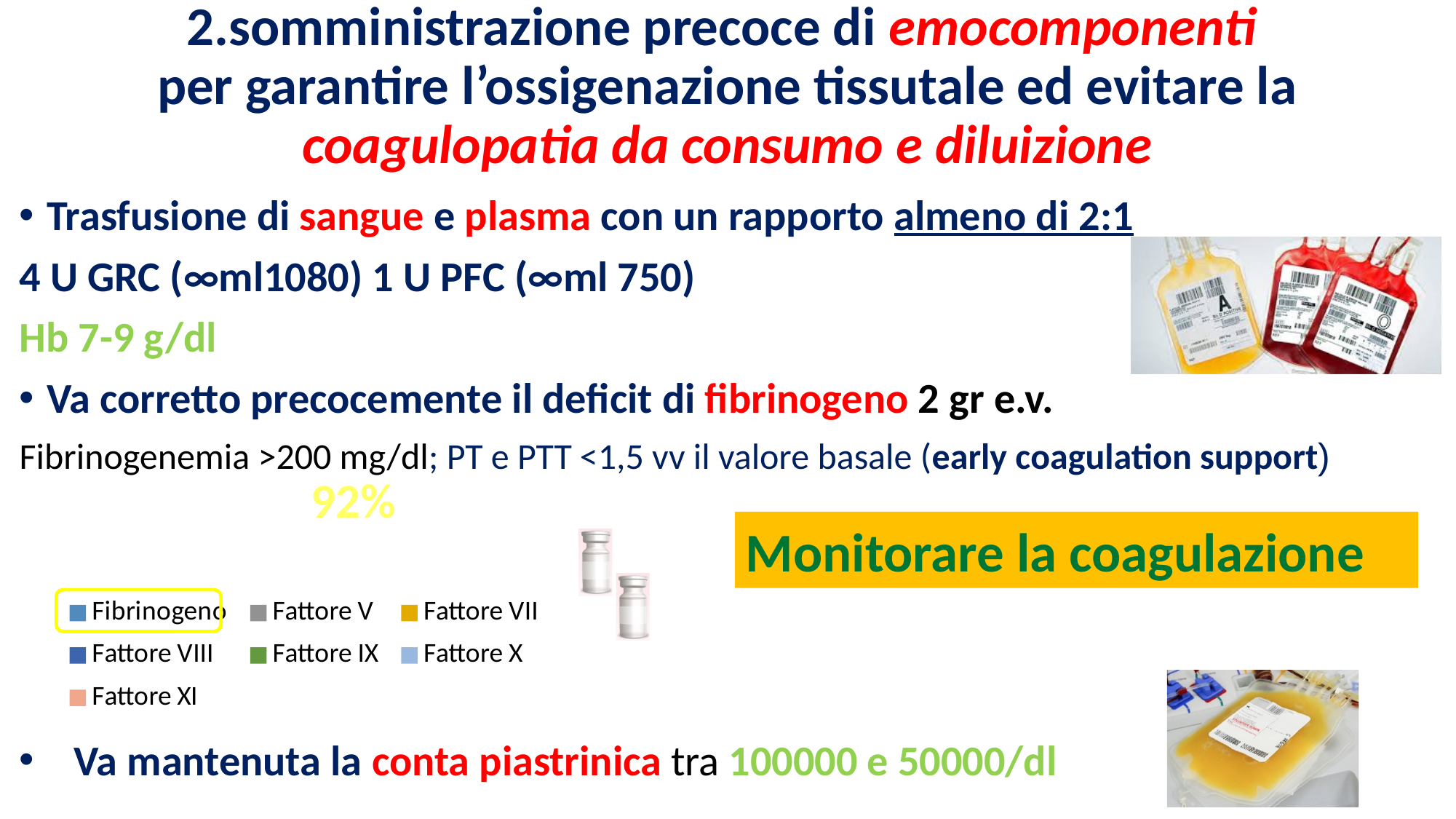
How many entries does the chart legend list? 7 What percentage value is printed as a data label on the chart? 92% Which legend entry of the chart is circled in yellow? Fibrinogeno Which legend entry is listed last in the chart legend? Fattore XI